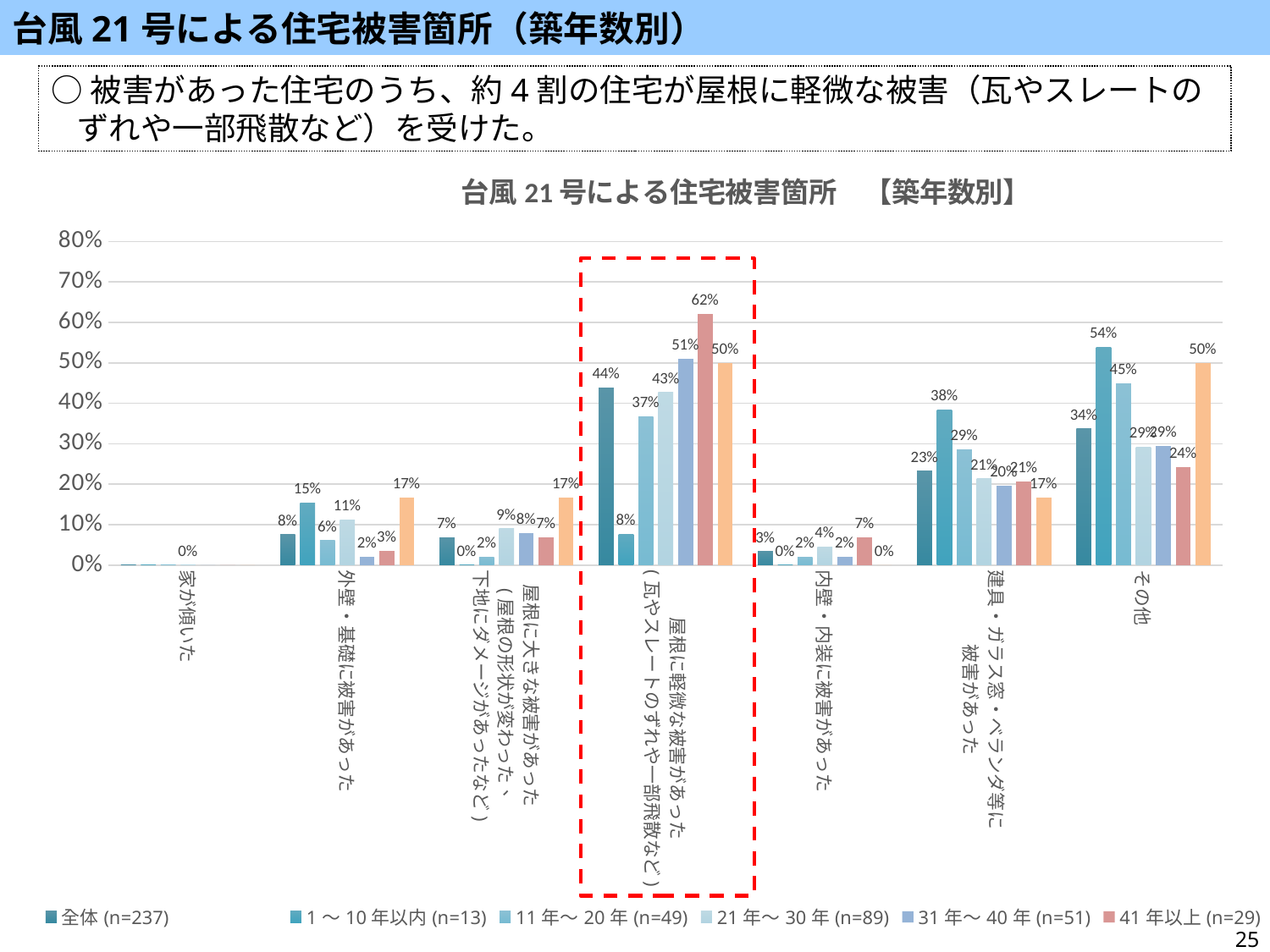
What is the value for 全体 (n=237) in the 屋根に軽微な被害があった category? 44% Is the value for 全体 (n=237) in the 家が傾いた category greater or less than 10%? less How many damage categories are shown along the x axis? 7 What is the title of the chart? 台風21号による住宅被害箇所 【築年数別】 What is the difference between the 全体 (n=237) values for 屋根に軽微な被害があった and 建具・ガラス窓・ベランダ等に被害があった? 21 percentage points What kind of chart is shown on the slide? Bar chart In the 建具・ガラス窓・ベランダ等に被害があった category, which is larger: the value for 1～10年以内 (n=13) or for 全体 (n=237)? 1～10年以内 (n=13) What is the value for 21年～30年 (n=89) in the 建具・ガラス窓・ベランダ等に被害があった category? 21% What is the value for 1～10年以内 (n=13) in the その他 category? 54% What is the value for 全体 (n=237) in the 外壁・基礎に被害があった category? 8% Which category has the highest value for the 全体 (n=237) series? 屋根に軽微な被害があった What is the value for 41年以上 (n=29) in the 屋根に軽微な被害があった category? 62%